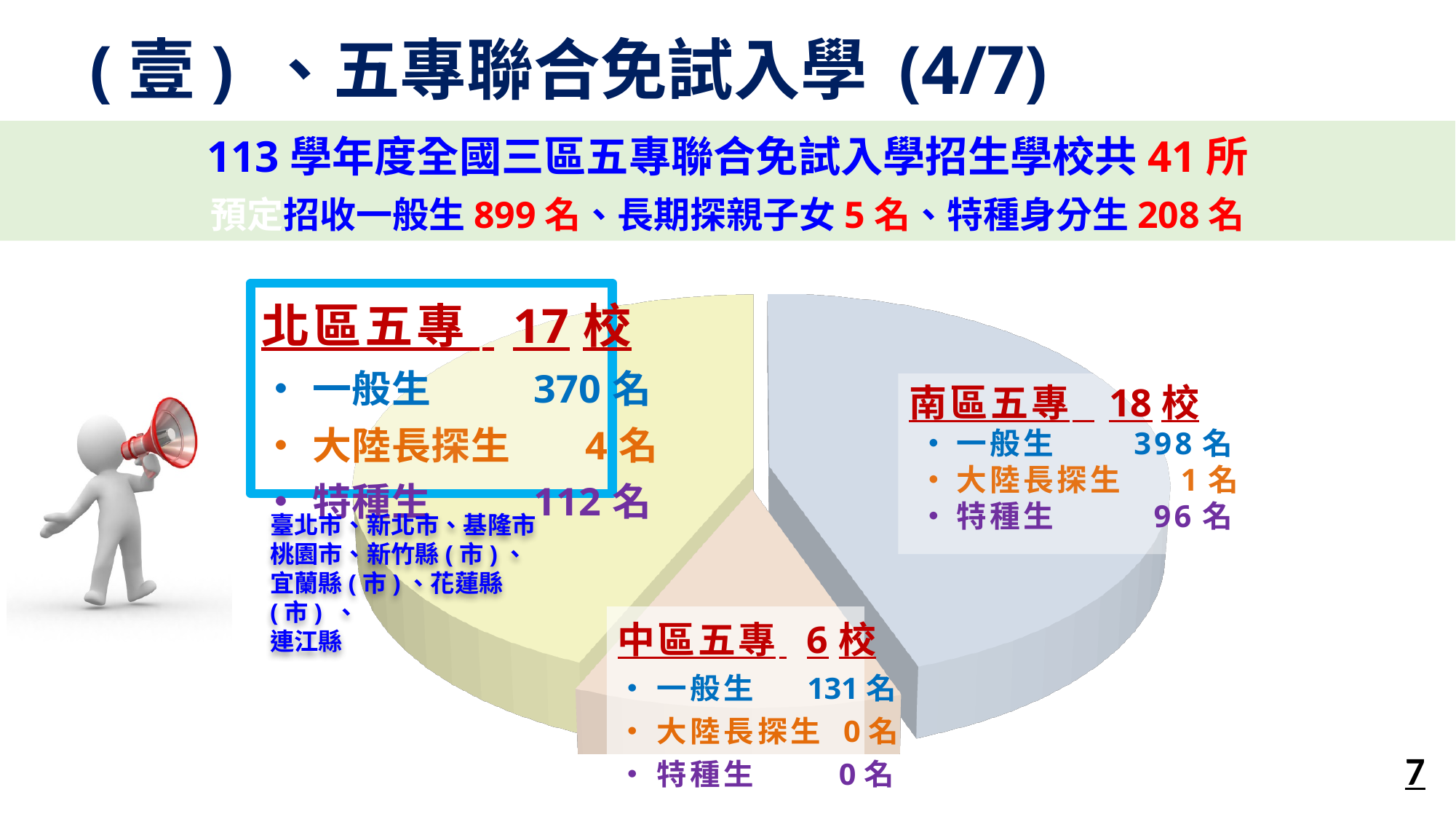
Which has more 特種生, 北區五專 or 南區五專? 北區五專 What is the difference in 一般生 between 南區五專 and 北區五專? 28 名 How many 特種生 does 北區五專 plan to admit? 112 名 How many regions (slices) does the pie chart show? 3 What is the difference in 大陸長探生 between 北區五專 and 南區五專? 3 名 What kind of chart is shown on the slide? Pie chart How many schools (校) does 北區五專 have? 17 校 Which region has the fewest schools (校)? 中區五專 How many schools (校) does 南區五專 have? 18 校 How many 大陸長探生 does 南區五專 plan to admit? 1 名 Which region has the most 一般生? 南區五專 How many 一般生 does 中區五專 plan to admit? 131 名